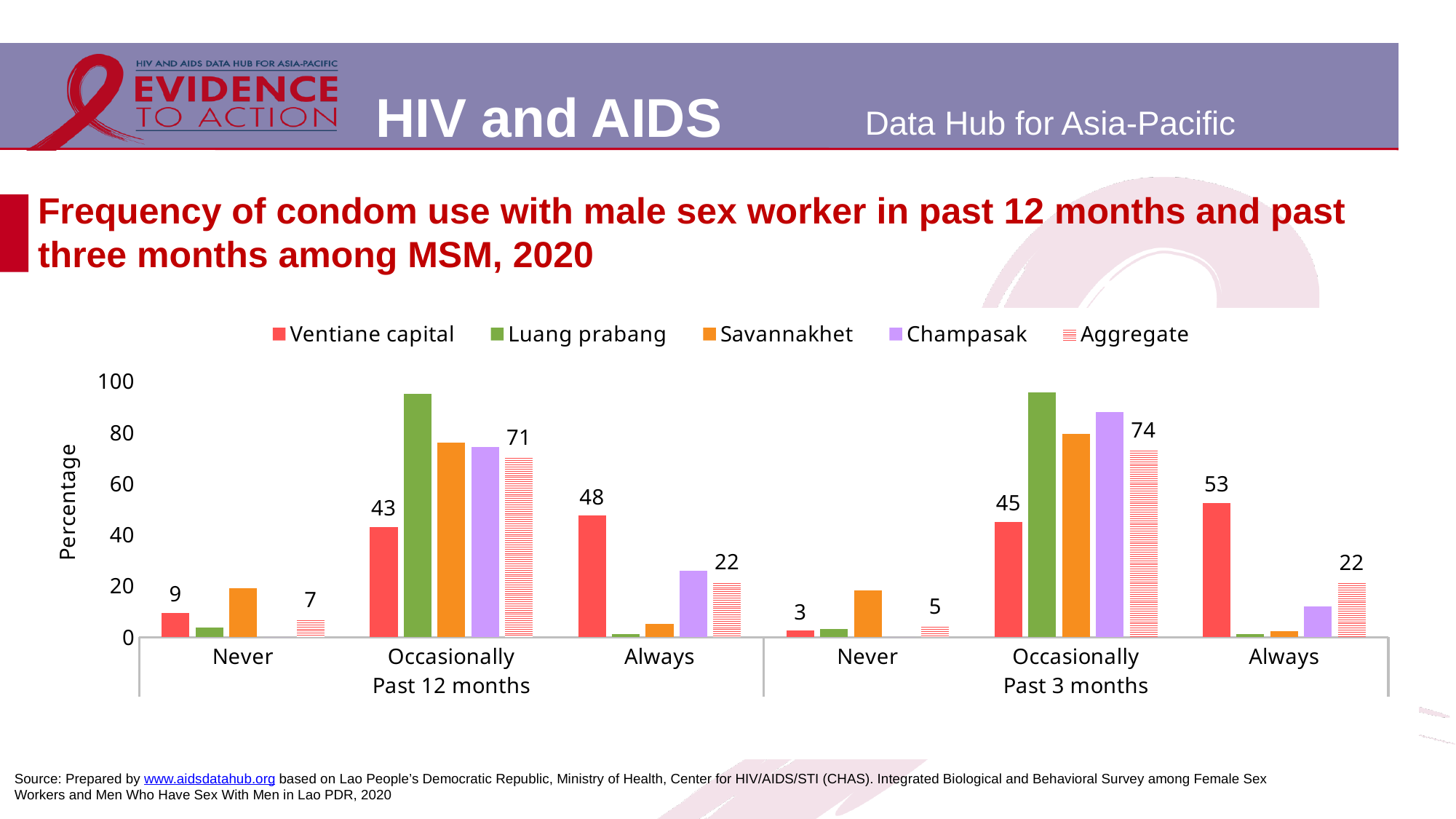
What is the Aggregate value for Never in the past 12 months? 7 What kind of chart is shown on the slide? bar chart What is the value for Ventiane capital for Occasionally in the past 12 months? 43 What is the difference between the Aggregate values for Occasionally in the past 3 months and Occasionally in the past 12 months? 3 What is the label of the vertical axis? Percentage Which series has the highest value for Occasionally in the past 12 months? Luang prabang Is the value for Champasak for Occasionally in the past 3 months greater or less than 80? greater What is the Aggregate value for Occasionally in the past 3 months? 74 What is the value for Ventiane capital for Always in the past 3 months? 53 How many series does the legend list? 5 Which is larger for Always in the past 12 months: Ventiane capital or Aggregate? Ventiane capital